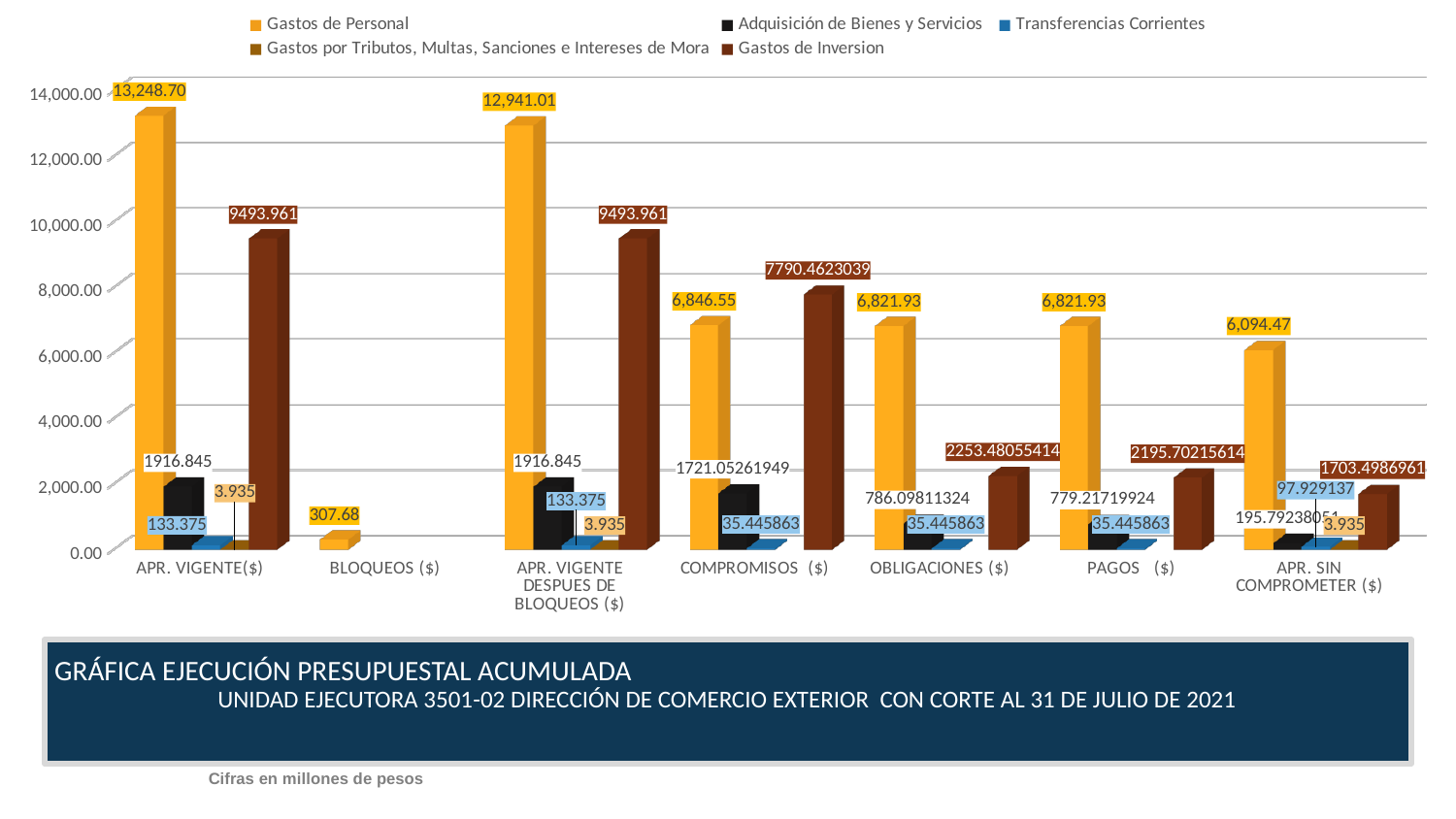
What is the value of Transferencias Corrientes for APR. SIN COMPROMETER ($)? 97.929137 How many series does the legend list? 5 What unit note is printed below the chart? Cifras en millones de pesos What is the difference between Gastos de Personal for APR. VIGENTE($) and for APR. VIGENTE DESPUES DE BLOQUEOS ($)? 307.69 What is the value of Gastos de Inversion for COMPROMISOS ($)? 7790.4623039 What kind of chart is shown on the slide? bar chart For COMPROMISOS ($), which is larger: Gastos de Personal or Gastos de Inversion? Gastos de Inversion How many categories are shown on the x axis? 7 Is the value of Gastos de Inversion for OBLIGACIONES ($) greater or less than 4,000.00? less Which category has the lowest value for Gastos de Personal? BLOQUEOS ($) Which category has the highest value for Gastos de Personal? APR. VIGENTE($) What is the value of Gastos de Personal for APR. VIGENTE($)? 13,248.70